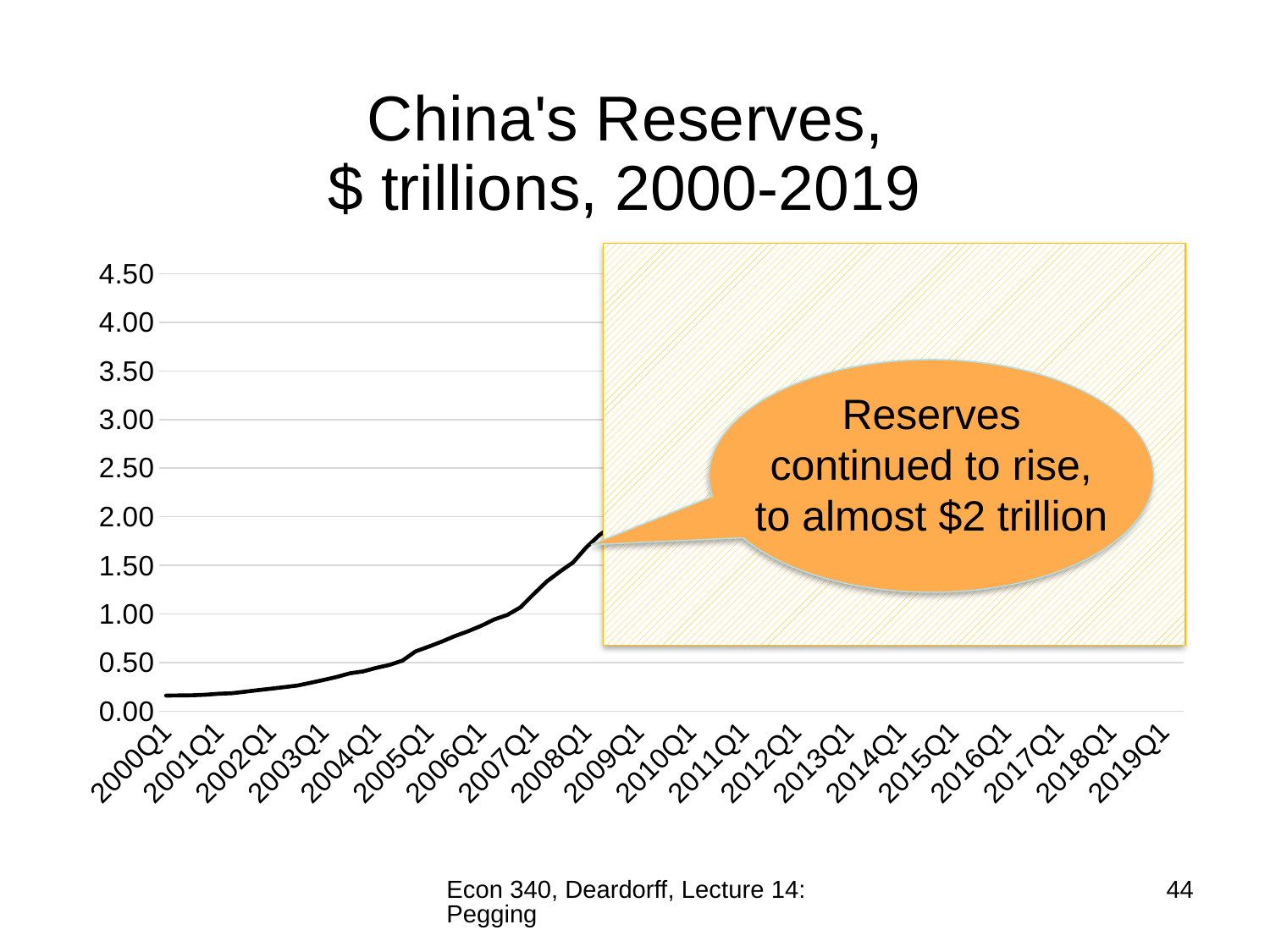
Is the value for 2006Q1 greater or less than 1.00? less Is the value for 2000Q1 greater or less than 0.50? less Is the value for 2008Q1 greater or less than 1.00? greater What kind of chart is shown on the slide? line chart How many year labels are shown on the x axis? 20 What is the highest value shown on the y axis? 4.50 Which is larger, the value for 2000Q1 or the value for 2008Q1? 2008Q1 Do China's reserves rise or fall from 2000Q1 to 2008Q1? rise What is the title of the chart? China's Reserves, $ trillions, 2000-2019